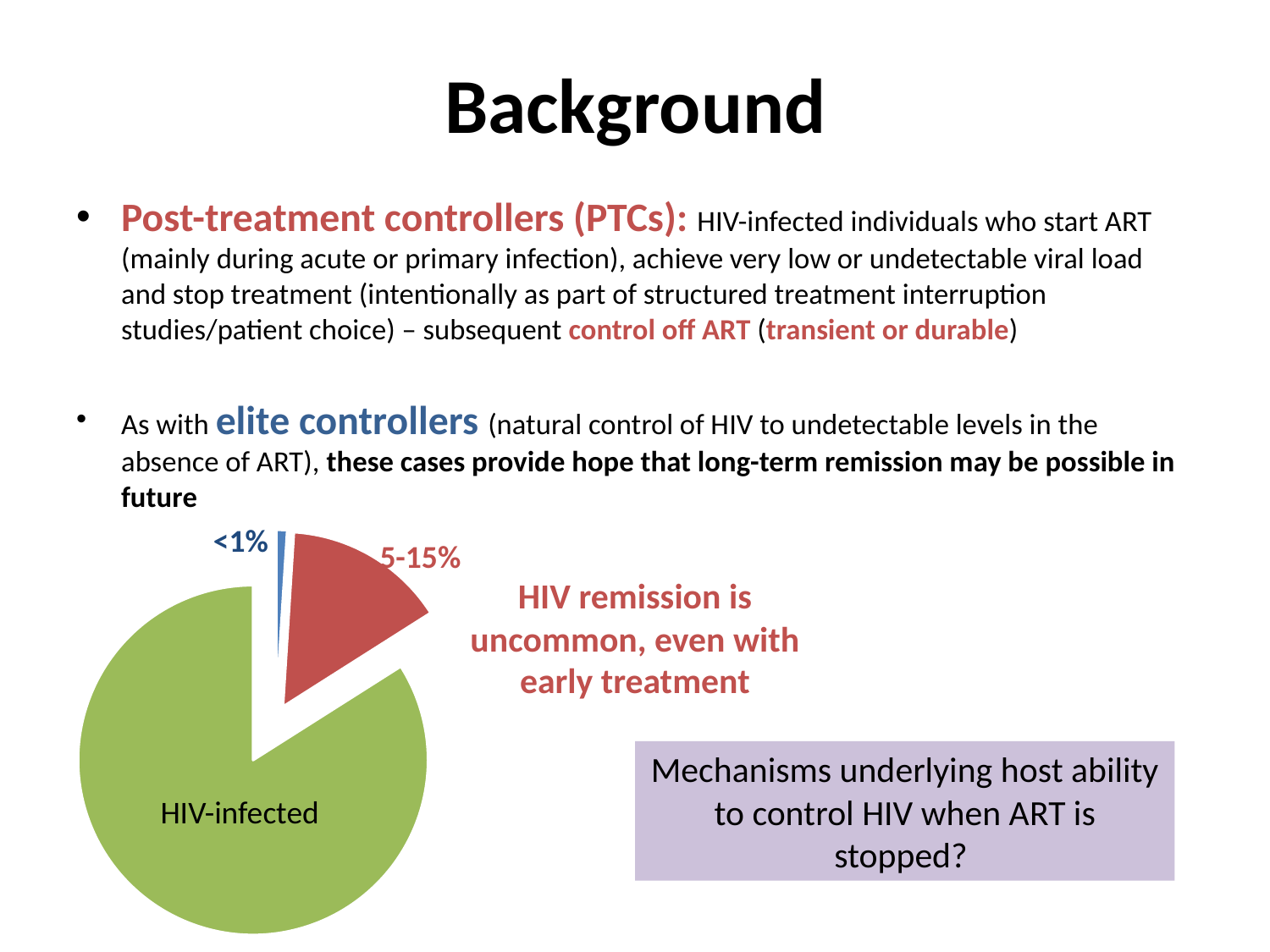
What kind of chart is shown on the slide? pie chart Which slice of the pie chart is the largest? HIV-infected What label is printed on the red slice of the pie chart? 5-15% What red text is written next to the pie chart? HIV remission is uncommon, even with early treatment Which slice of the pie chart is the smallest? <1% What label is printed on the blue slice of the pie chart? <1% What colour is the HIV-infected slice of the pie chart? green Which is larger in the pie chart, the 5-15% slice or the <1% slice? 5-15% Which is larger in the pie chart, the HIV-infected slice or the 5-15% slice? HIV-infected How many slices does the pie chart have? 3